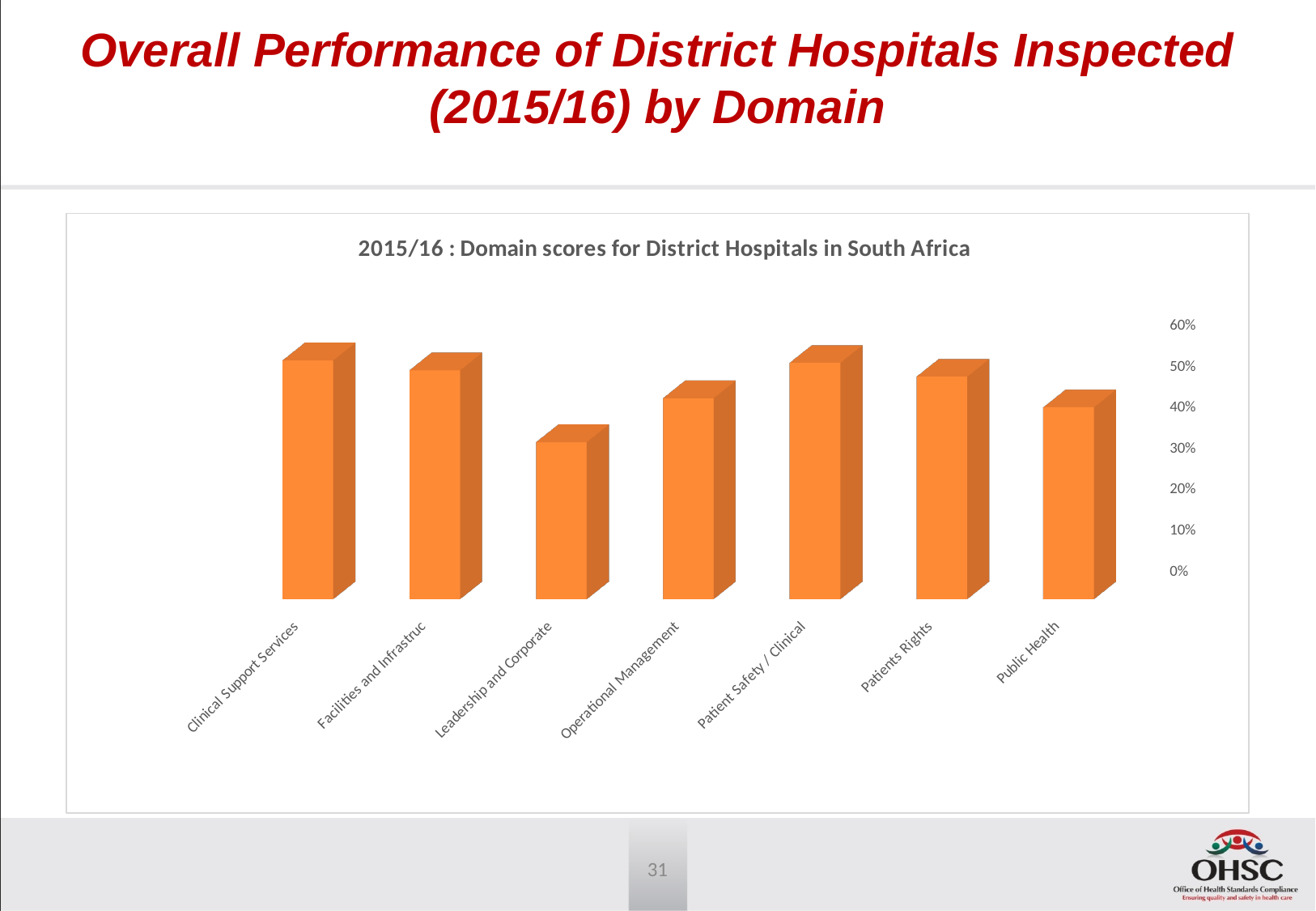
What kind of chart is shown on the slide? Bar chart How many domains (categories) are plotted in the chart? 7 Is the value for Operational Management greater or less than 50%? less Is the value for Clinical Support Services greater or less than 40%? greater Which domain has the lowest score in the chart? Leadership and Corporate Is the value for Patients Rights greater or less than 40%? greater Which is larger, the value for Leadership and Corporate or the value for Operational Management? Operational Management What is the title of the chart? 2015/16 : Domain scores for District Hospitals in South Africa Which is larger, the value for Public Health or the value for Clinical Support Services? Clinical Support Services What colour are the bars in the chart? Orange